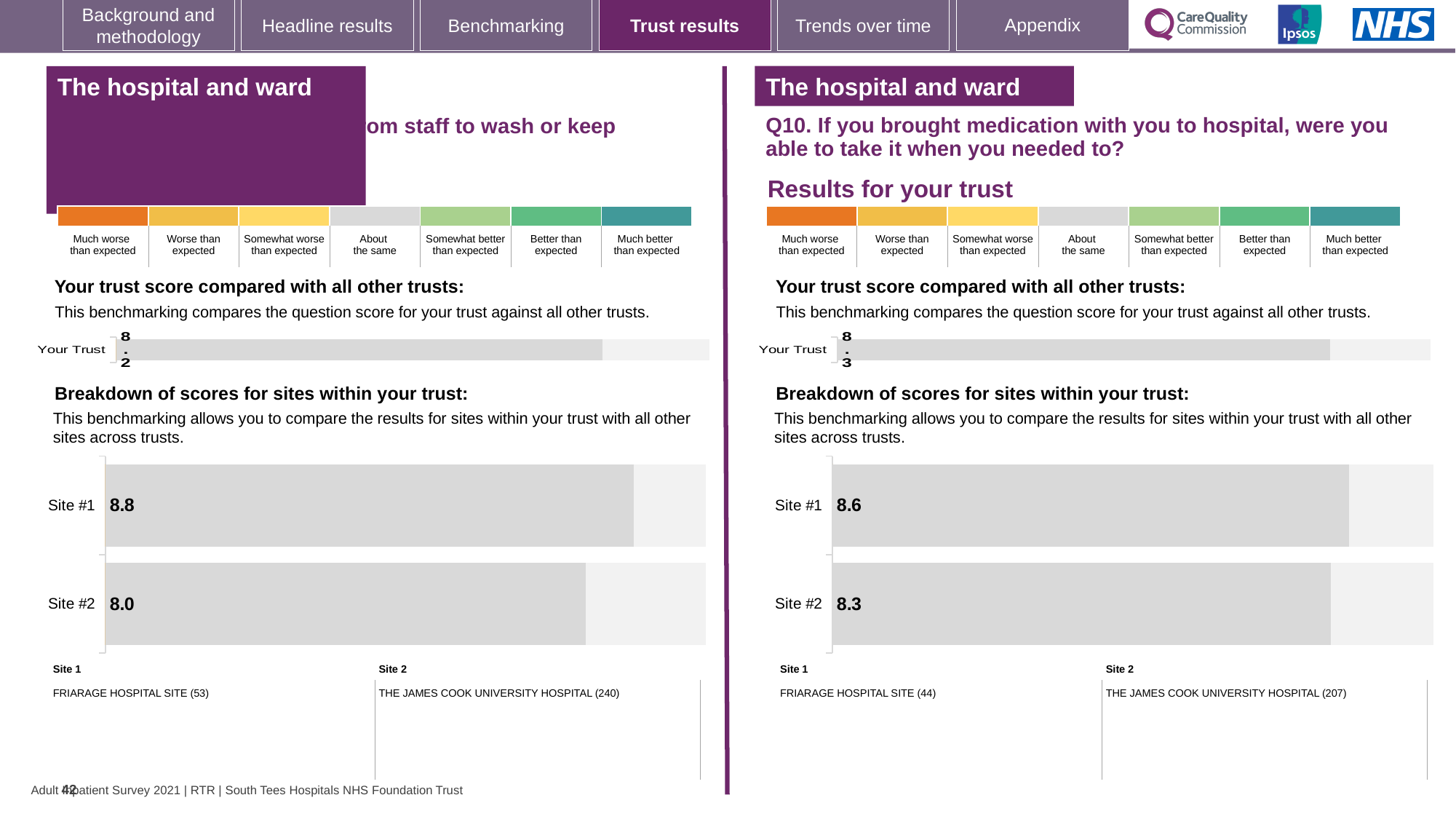
On the left-hand site breakdown chart, what is the score for Site #1? 8.8 On the right-hand (Q10) site breakdown chart, what is the difference between the Site #1 and Site #2 scores? 0.3 On the left-hand 'Your trust score compared with all other trusts' chart, what is the score for Your Trust? 8.2 On the left-hand site breakdown chart, what is the score for Site #2? 8.0 On the left-hand site breakdown chart, which site has the higher score? Site #1 On the right-hand (Q10) site breakdown chart, what is the score for Site #2? 8.3 On the right-hand (Q10) 'Your trust score compared with all other trusts' chart, what is the score for Your Trust? 8.3 On the right-hand (Q10) site breakdown chart, what is the score for Site #1? 8.6 How many sites are shown on the right-hand (Q10) site breakdown chart? 2 What type of chart is the left-hand site breakdown chart? Bar chart On the left-hand site breakdown chart, what is the difference between the Site #1 and Site #2 scores? 0.8 On the right-hand (Q10) site breakdown chart, which site has the lower score? Site #2